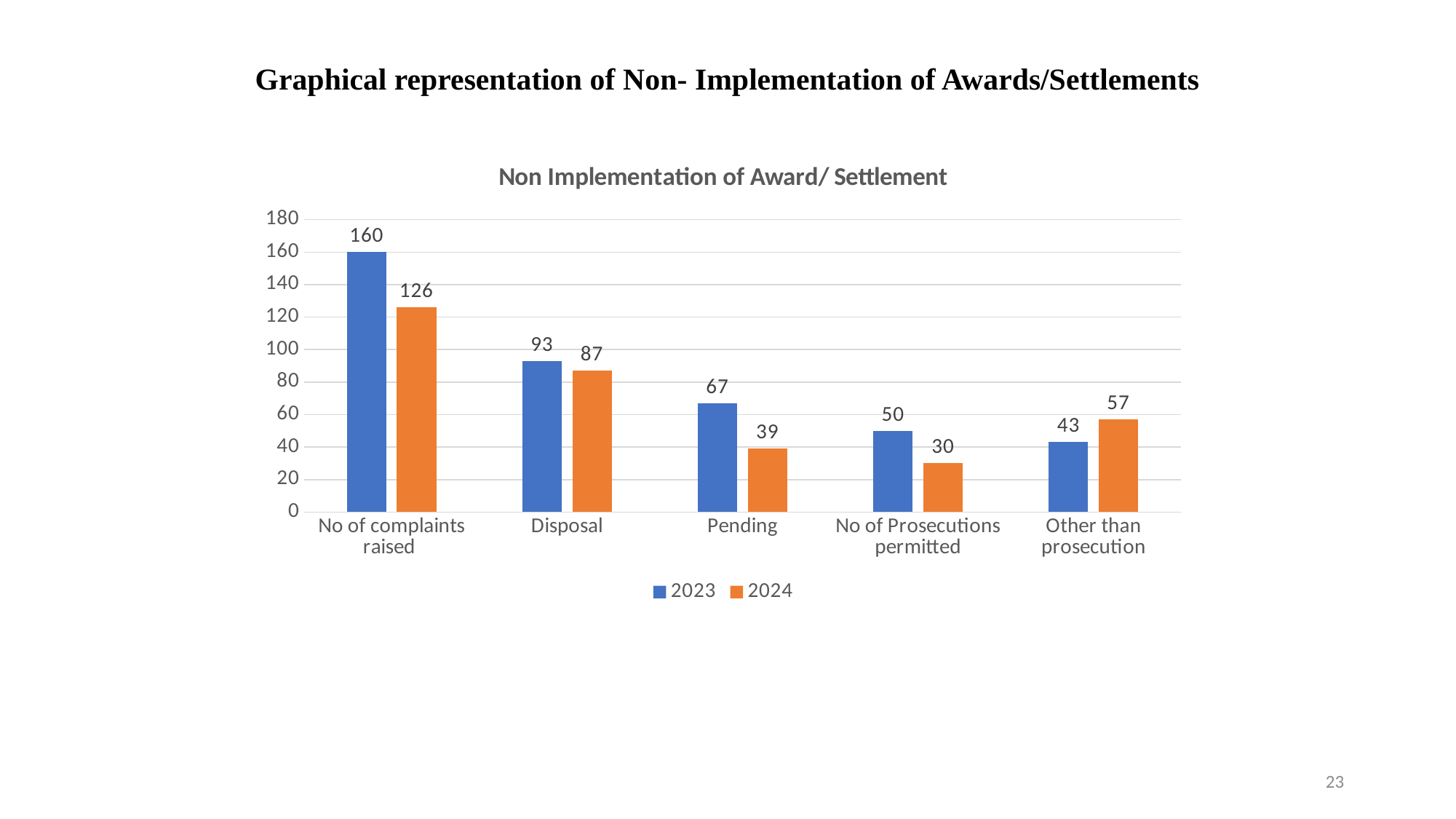
Which category has the highest value for 2023? No of complaints raised Which category has the lowest value for 2024? No of Prosecutions permitted What is the title of the chart? Non Implementation of Award/ Settlement What is the value for 2024 in the 'Pending' category? 39 Which is larger for 'Other than prosecution': the 2023 value or the 2024 value? 2024 What is the value for 2024 in the 'Other than prosecution' category? 57 What kind of chart is shown on the slide? Bar chart What is the difference between the 2023 and 2024 values for 'Disposal'? 6 What is the difference between the 2023 and 2024 values for 'No of complaints raised'? 34 How many categories are shown on the x axis? 5 What is the value for 2023 in the 'No of complaints raised' category? 160 How many series does the legend list? 2